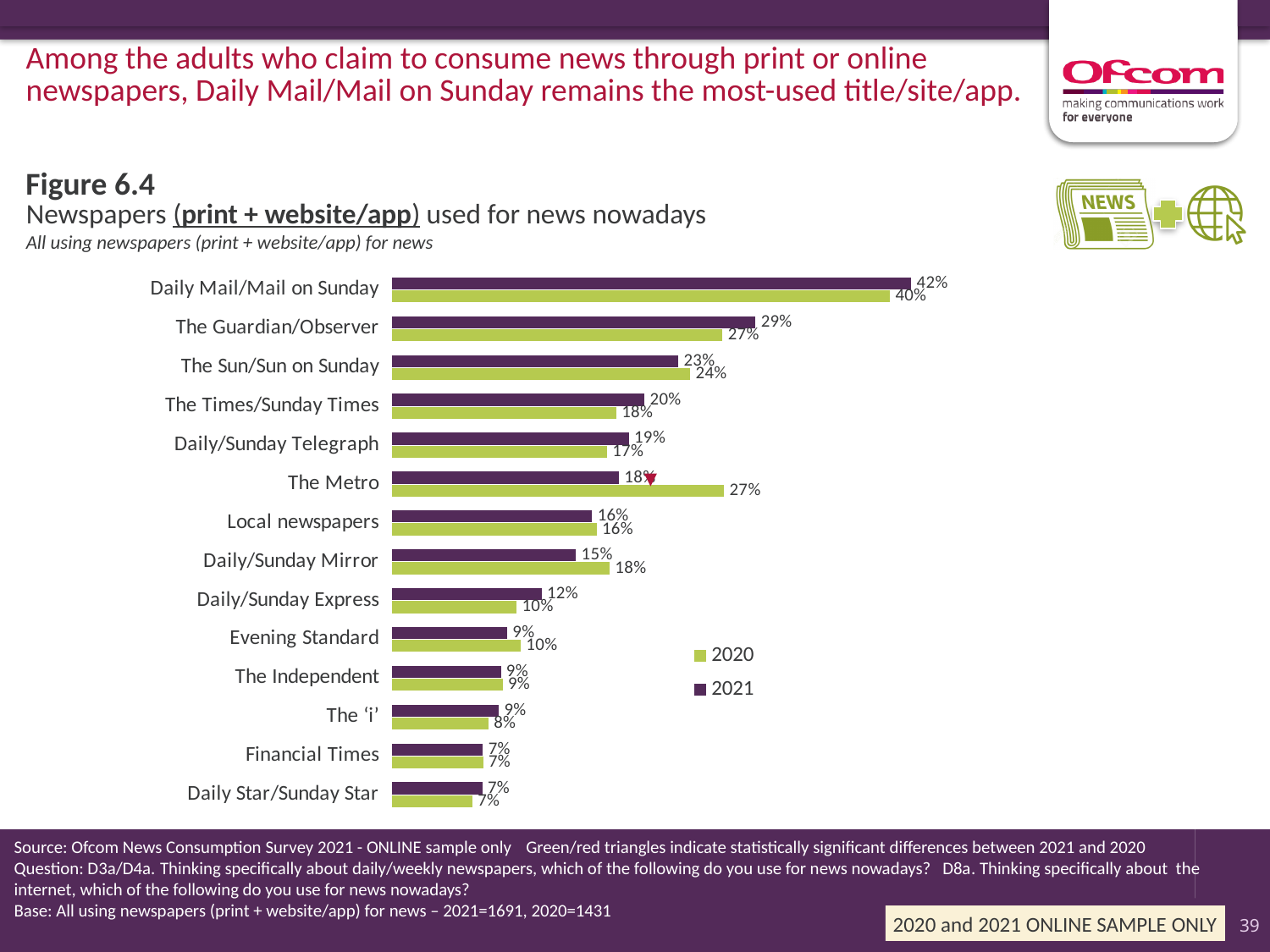
What is the 2021 value for The Guardian/Observer? 29% Which newspaper has the lowest 2020 value? Financial Times and Daily Star/Sunday Star (both 7%) Which colour represents 2021 in the chart? Purple What percentage used Daily Mail/Mail on Sunday for news in 2021? 42% What is the 2020 value for Daily/Sunday Mirror? 18% What percentage used The Metro for news in 2020? 27% What type of chart is shown? Bar chart Which newspaper has the highest 2021 value? Daily Mail/Mail on Sunday How many newspapers are listed in the chart? 14 How many series does the legend list? 2 Which is larger for The Sun/Sun on Sunday: the 2020 value or the 2021 value? 2020 (24%) What is the difference between the 2020 and 2021 values for The Metro? 9 percentage points